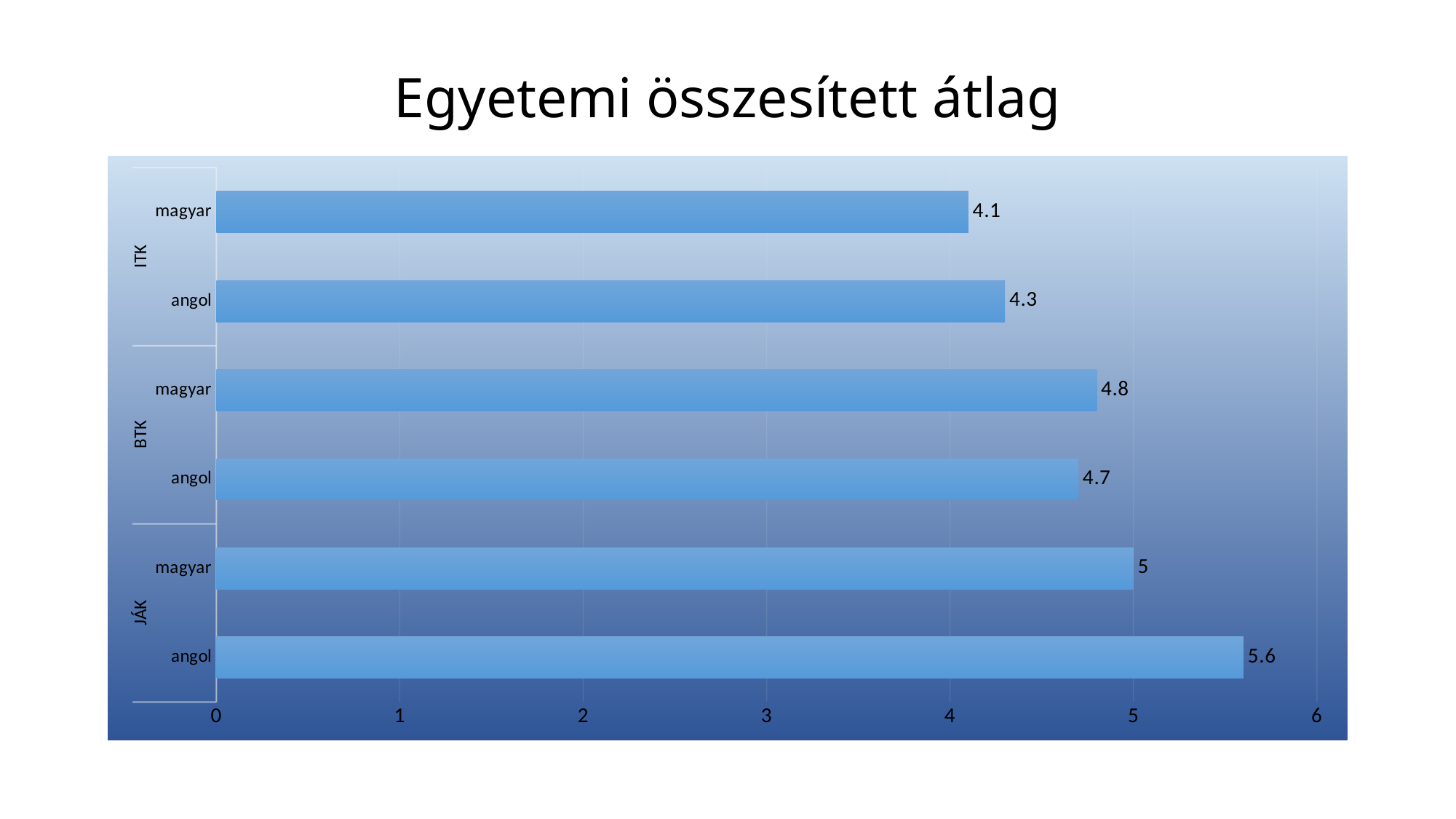
What is the value for JÁK angol? 5.6 What kind of chart is shown? bar chart Which is larger, BTK magyar or BTK angol? BTK magyar What is the value for BTK angol? 4.7 How many bars are plotted in the chart? 6 What is the difference between ITK angol and ITK magyar? 0.2 Which bar has the lowest value? ITK magyar Is the value for JÁK angol greater or less than 5? greater What is the value for ITK magyar? 4.1 What is the difference between JÁK angol and JÁK magyar? 0.6 What is the title of the chart? Egyetemi összesített átlag Which bar has the highest value? JÁK angol